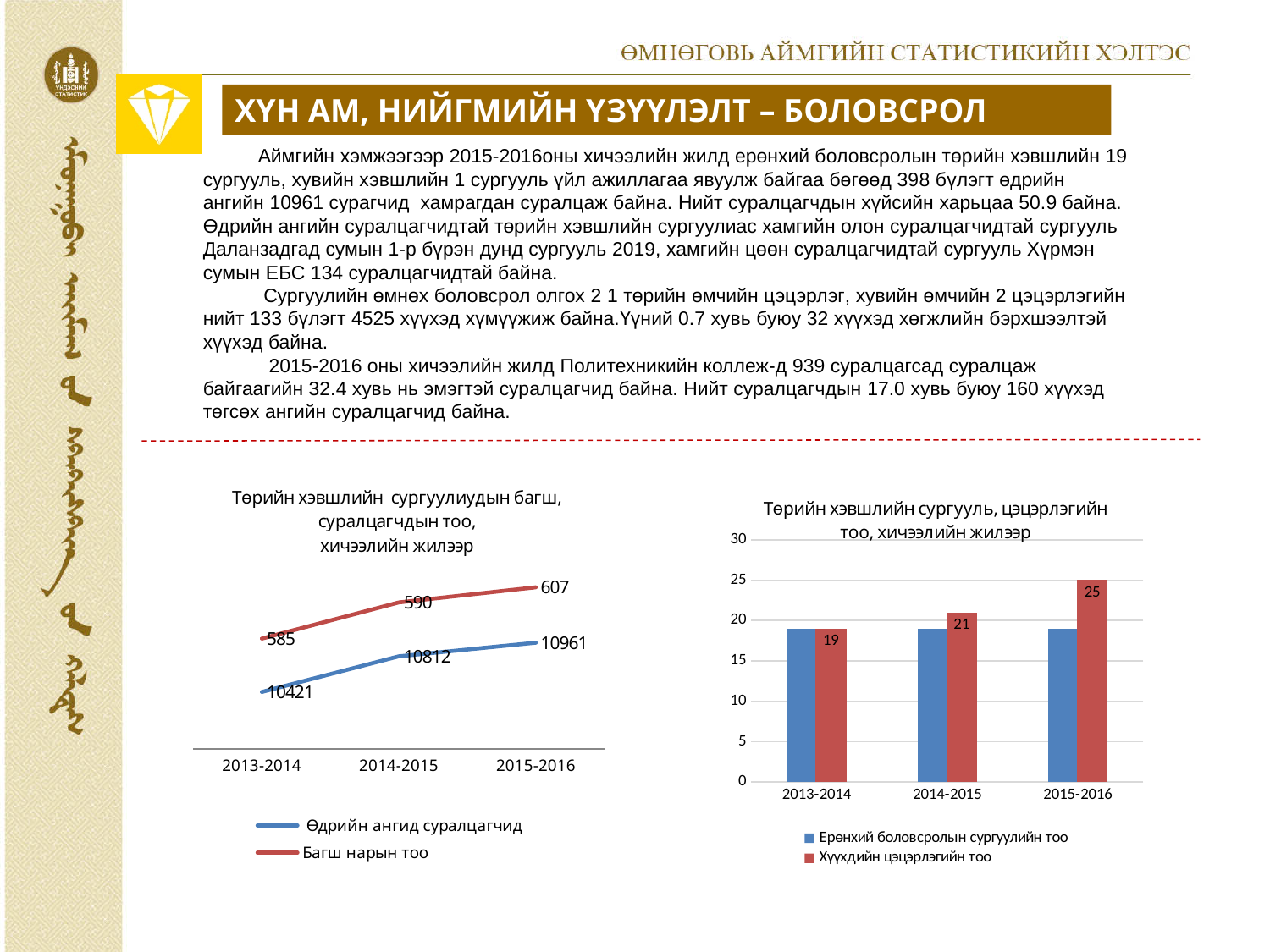
On the right chart, in which year is Хүүхдийн цэцэрлэгийн тоо lowest? 2013-2014 On the left chart, what is the difference between the Өдрийн ангид суралцагчид values for 2015-2016 and 2013-2014? 540 What kind of chart is the left chart? line chart On the left chart, what is the value for Багш нарын тоо in 2014-2015? 590 How many series does the legend of the left chart list? 2 On the left chart, what is the value for Багш нарын тоо in 2013-2014? 585 On the left chart, does the Багш нарын тоо series rise or fall from 2013-2014 to 2015-2016? rise On the right chart, what is the difference between Хүүхдийн цэцэрлэгийн тоо in 2015-2016 and 2014-2015? 4 On the right chart, what is the value for Хүүхдийн цэцэрлэгийн тоо in 2015-2016? 25 On the left chart, what is the value for Өдрийн ангид суралцагчид in 2015-2016? 10961 On the right chart, is the value for Ерөнхий боловсролын сургуулийн тоо in 2013-2014 greater or less than 15? greater What kind of chart is the right chart? bar chart